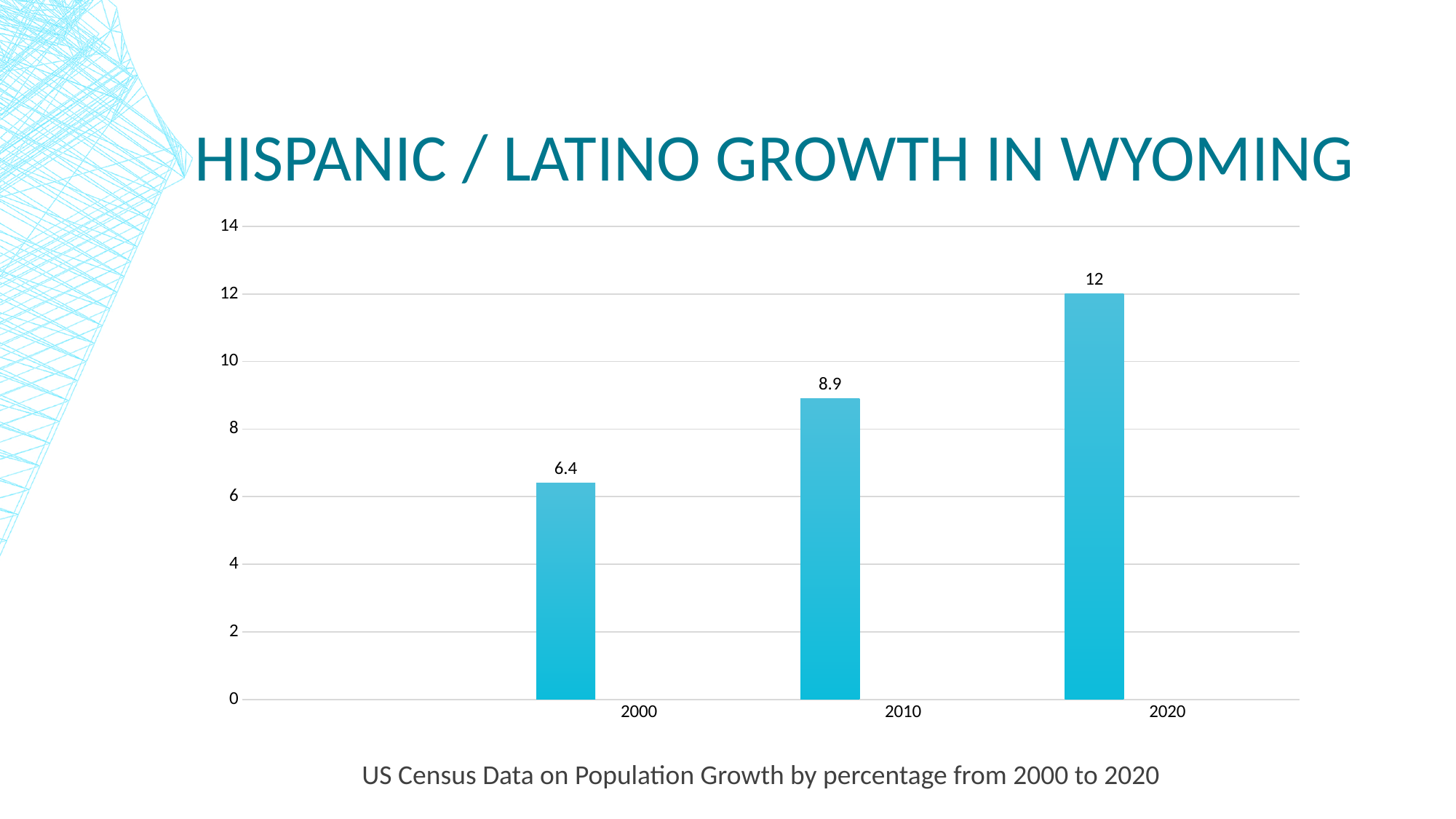
Which is larger, the value for 2010 or the value for 2020? 2020 Which year has the highest value? 2020 Do the values rise or fall from 2000 to 2020? rise What kind of chart is shown on the slide? bar chart What is the difference between the values for 2010 and 2000? 2.5 What is the value for 2020? 12 Is the value for 2010 greater or less than 8? greater What is the value for 2010? 8.9 What is the value for 2000? 6.4 How many years are shown on the x axis? 3 Which year has the lowest value? 2000 What is the difference between the values for 2020 and 2000? 5.6